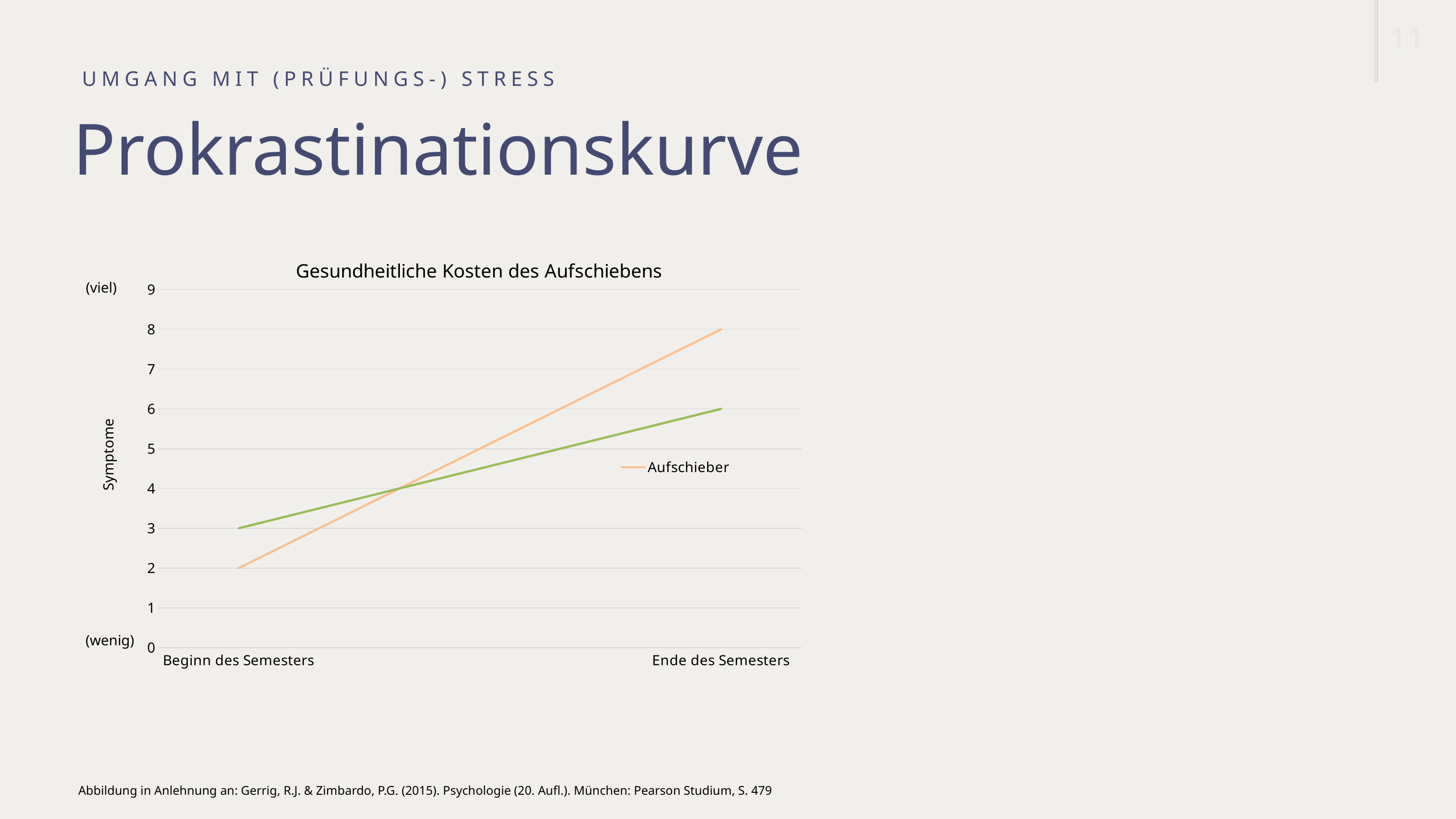
Which is larger for Aufschieber: the value at Beginn des Semesters or at Ende des Semesters? Ende des Semesters Does the Aufschieber line rise or fall from Beginn des Semesters to Ende des Semesters? rise What is the value for Aufschieber at Beginn des Semesters? 2 By how much does the Aufschieber value increase from Beginn des Semesters to Ende des Semesters? 6 What is the title of the chart? Gesundheitliche Kosten des Aufschiebens What kind of chart is shown on the slide? line chart Is the value for Aufschieber at Ende des Semesters greater or less than 5? greater What is the value for Aufschieber at Ende des Semesters? 8 At which x-axis category does Aufschieber reach its highest value? Ende des Semesters What is the label of the y axis? Symptome How many series does the chart's legend list? 1 How many categories are shown on the x axis? 2